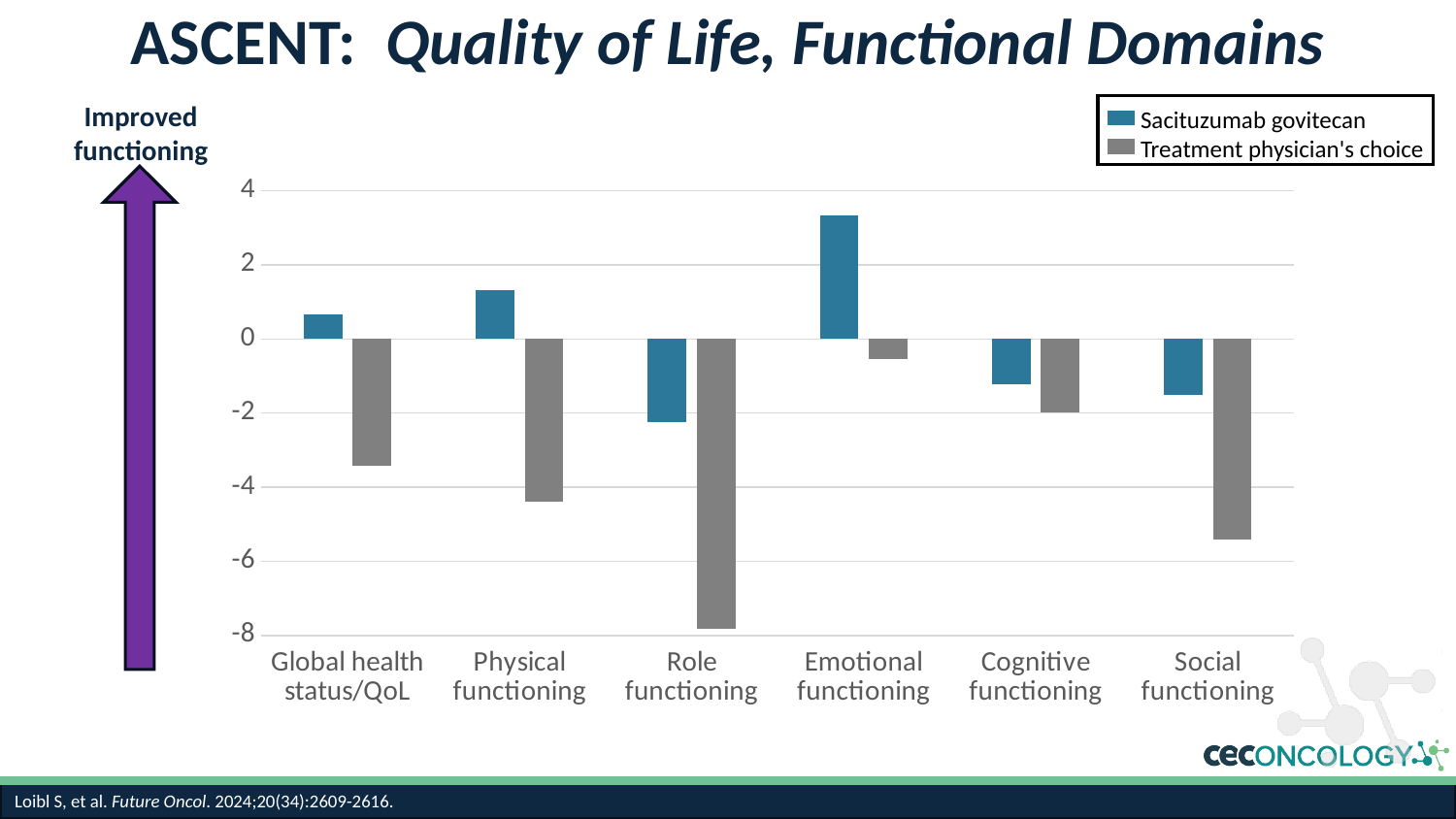
For which domain is the Sacituzumab govitecan value highest? Emotional functioning Is the Treatment physician's choice value for Physical functioning greater or less than -2? less What are the two series named in the legend? Sacituzumab govitecan and Treatment physician's choice What kind of chart is shown on the slide? bar chart Is the Treatment physician's choice value for Role functioning greater or less than -6? less What does the purple arrow to the left of the chart indicate? Improved functioning For which domain is the Sacituzumab govitecan value lowest? Role functioning For which domain is the Treatment physician's choice value lowest? Role functioning How many series does the legend list? 2 Is the Sacituzumab govitecan value for Emotional functioning greater or less than 2? greater For Global health status/QoL, which series has the larger value, Sacituzumab govitecan or Treatment physician's choice? Sacituzumab govitecan How many functional domain categories are shown on the x axis? 6